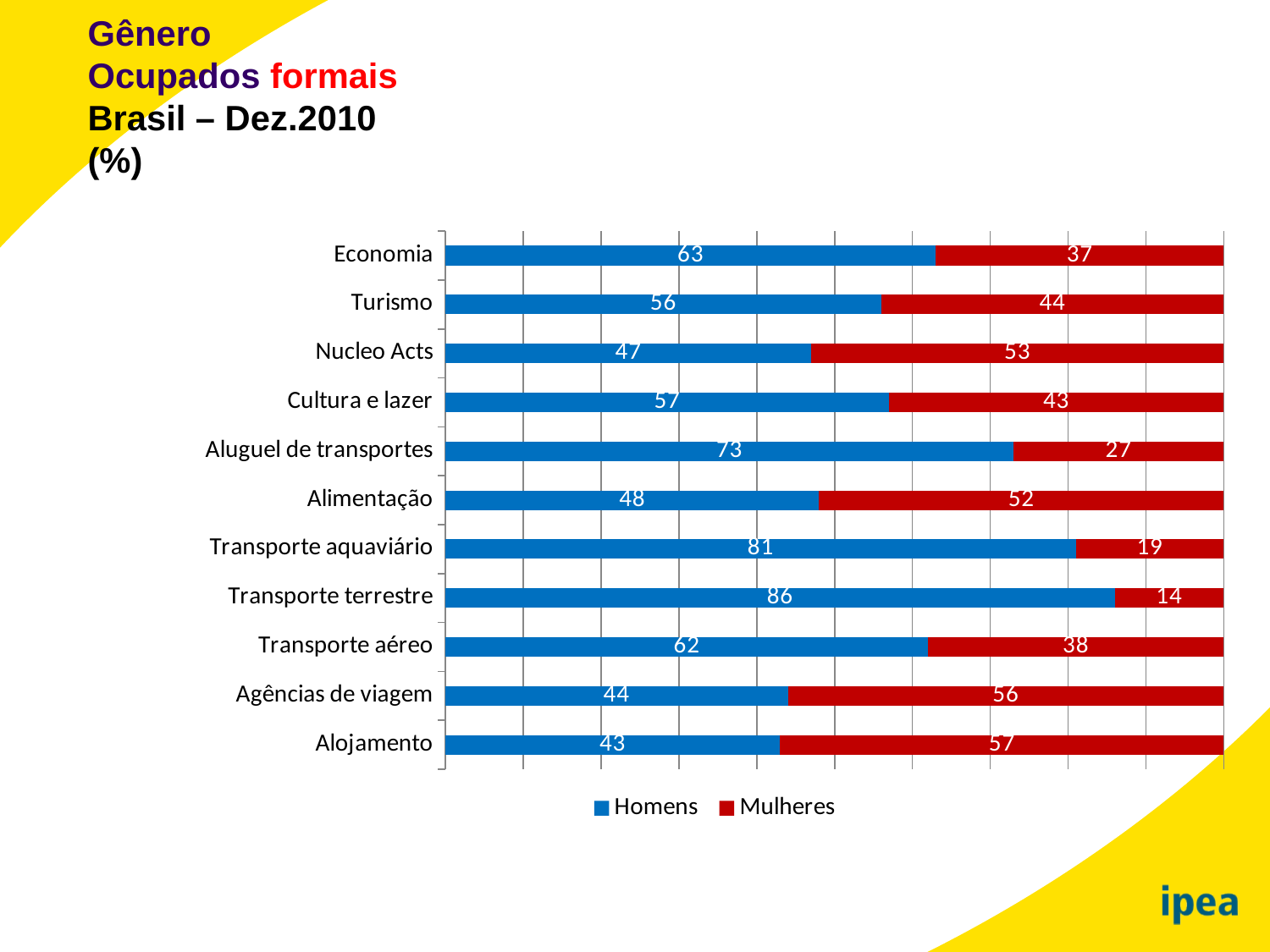
What is the difference between the Homens and Mulheres values for Economia? 26 What is the Homens value for Aluguel de transportes? 73 What kind of chart is shown on the slide? Stacked bar chart Which category has the lowest Mulheres value? Transporte terrestre What is the Homens value for Transporte terrestre? 86 How many series does the legend list? 2 What is the Mulheres value for Alojamento? 57 Which is larger for Nucleo Acts, the Homens value or the Mulheres value? Mulheres Which category has the highest Mulheres value? Alojamento Which category has the highest Homens value? Transporte terrestre What is the total of the stacked bar for Turismo? 100 How many categories are shown on the chart? 11